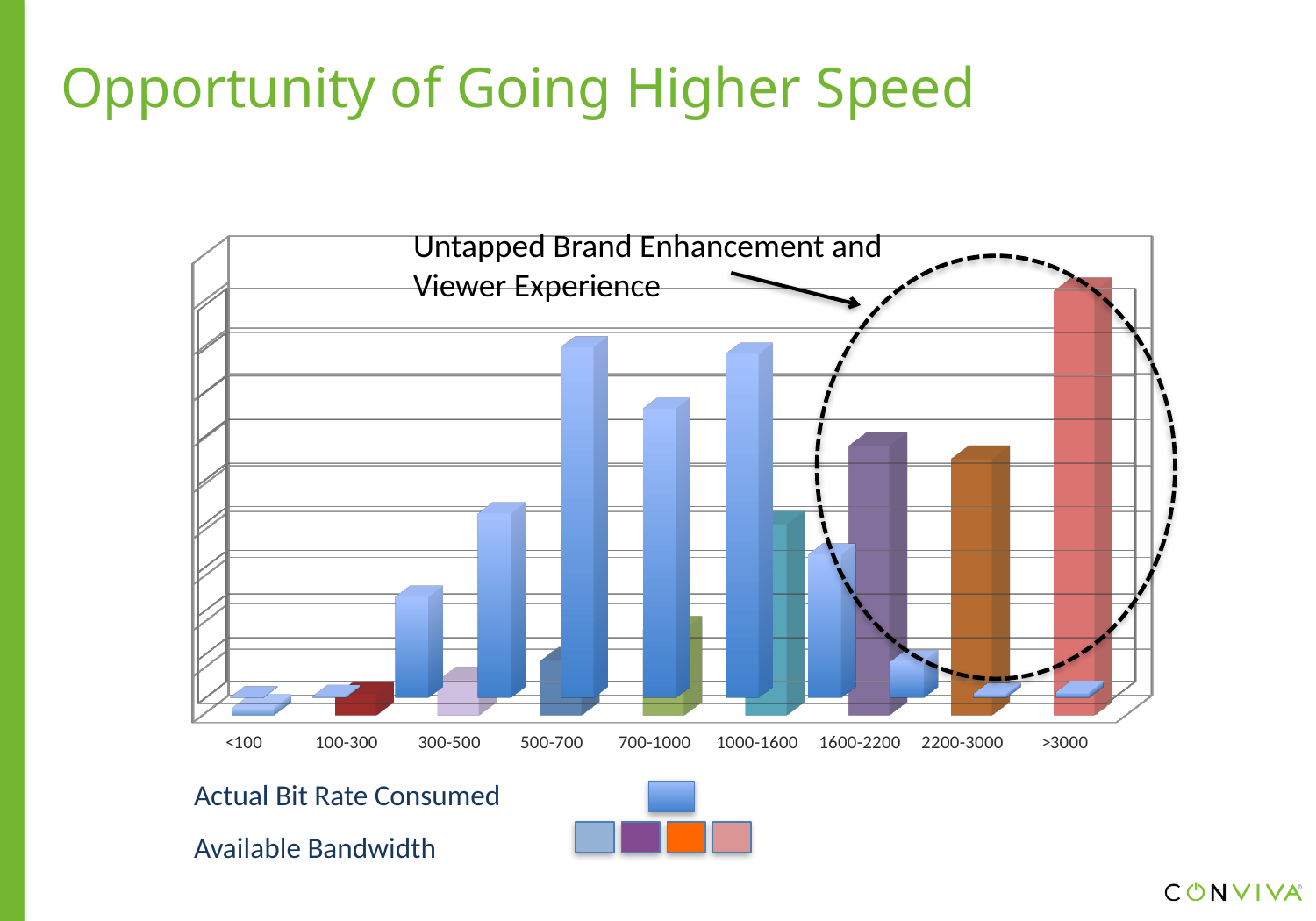
What kind of chart is shown on the slide? bar chart What does the annotation pointing to the dashed circle say? Untapped Brand Enhancement and Viewer Experience In the 2200-3000 category, which is larger: Actual Bit Rate Consumed or Available Bandwidth? Available Bandwidth In the 1600-2200 category, which is larger: Actual Bit Rate Consumed or Available Bandwidth? Available Bandwidth In the 700-1000 category, which is larger: Actual Bit Rate Consumed or Available Bandwidth? Actual Bit Rate Consumed How many bit-rate categories are shown along the x axis? 9 Which category has the tallest bar on the whole chart? >3000 What is the title of the slide containing the chart? Opportunity of Going Higher Speed How many series does the legend list? 2 Which category has the tallest Available Bandwidth bar? >3000 Do the Available Bandwidth bars generally rise or fall from left to right along the x axis? rise